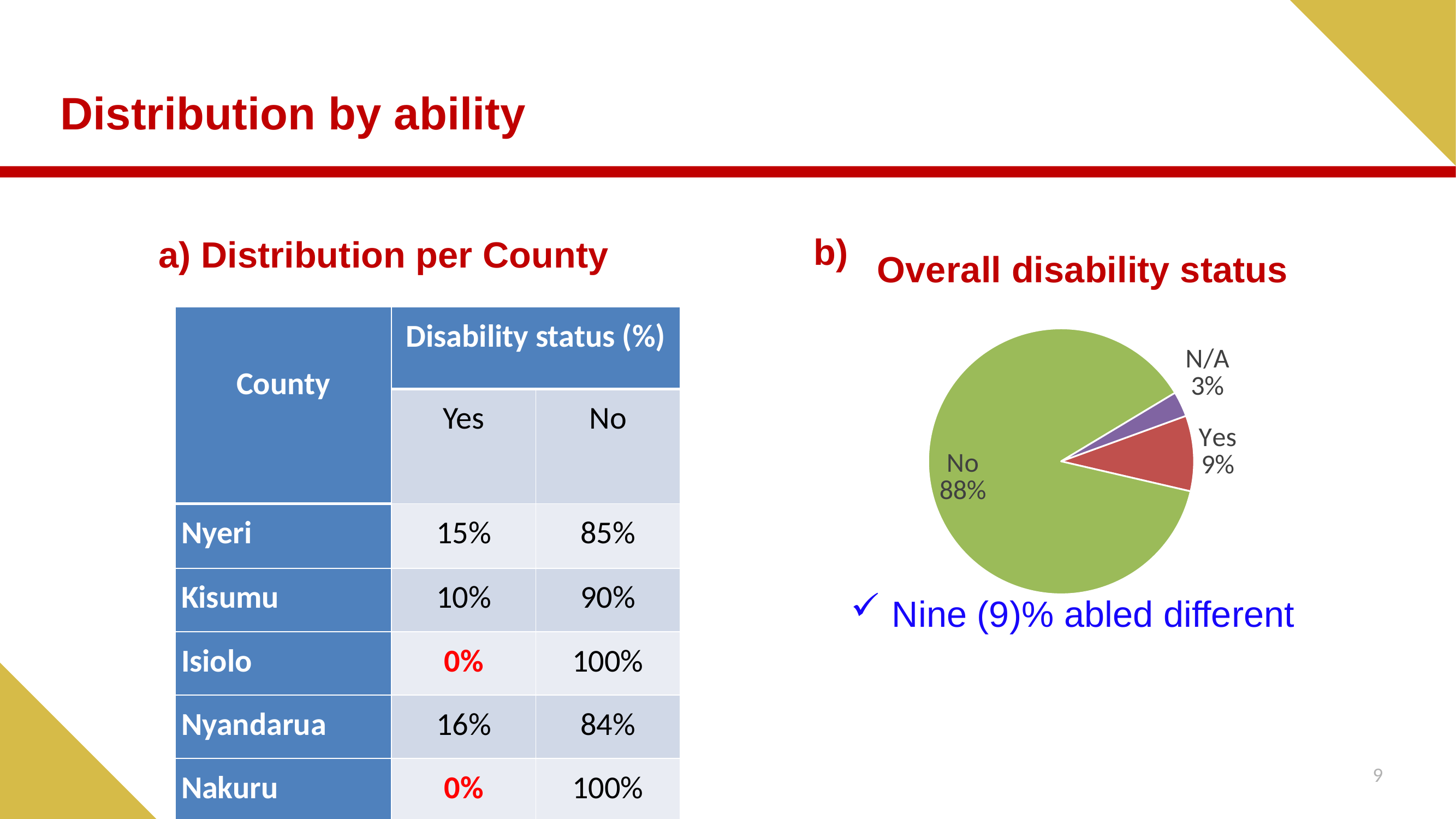
What colour is the "Yes" slice in the "Overall disability status" pie chart? red How many slices does the "Overall disability status" pie chart have? 3 Which slice of the "Overall disability status" pie chart is the smallest? N/A Which slice of the "Overall disability status" pie chart is the largest? No In the "Overall disability status" pie chart, what is the difference between the "No" share and the "Yes" share? 79% In the "Overall disability status" pie chart, what share is labelled "No"? 88% What kind of chart is shown under "Overall disability status"? pie chart In the "Overall disability status" pie chart, what is the difference between the "Yes" share and the "N/A" share? 6% In the "Overall disability status" pie chart, what share is labelled "Yes"? 9% What colour is the "No" slice in the "Overall disability status" pie chart? green In the "Overall disability status" pie chart, what share is labelled "N/A"? 3% In the "Overall disability status" pie chart, which is larger, the "Yes" slice or the "N/A" slice? Yes